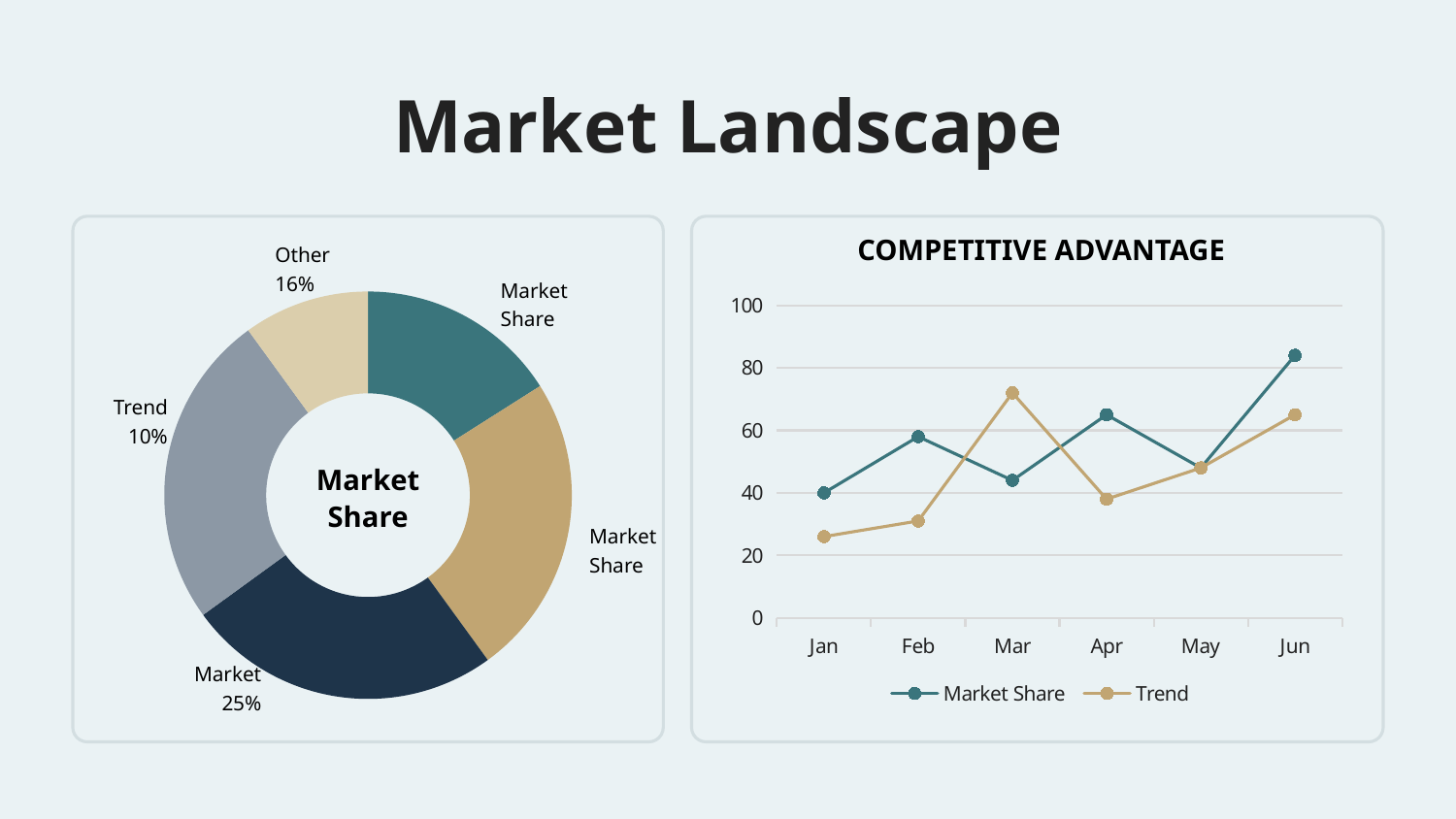
In the COMPETITIVE ADVANTAGE chart, which series has the larger value in Mar, Market Share or Trend? Trend In the Market Share donut chart, how many slices does the donut have? 5 In the COMPETITIVE ADVANTAGE chart, is the Trend value for Jan greater or less than 40? less In the COMPETITIVE ADVANTAGE chart, in which month is the Trend series lowest? Jan What kind of chart is the chart on the left of the slide? Donut (pie) chart In the COMPETITIVE ADVANTAGE chart, is the Market Share value for Jun greater or less than 80? greater In the COMPETITIVE ADVANTAGE chart, how many months are shown on the x axis? 6 In the Market Share donut chart, what is the difference between the Other slice and the Trend slice? 6% In the Market Share donut chart, what percentage is shown for the Trend slice? 10% In the COMPETITIVE ADVANTAGE chart, how many series does the legend list? 2 In the Market Share donut chart, what percentage is shown for the Other slice? 16% In the COMPETITIVE ADVANTAGE chart, in which month is the Market Share series highest? Jun